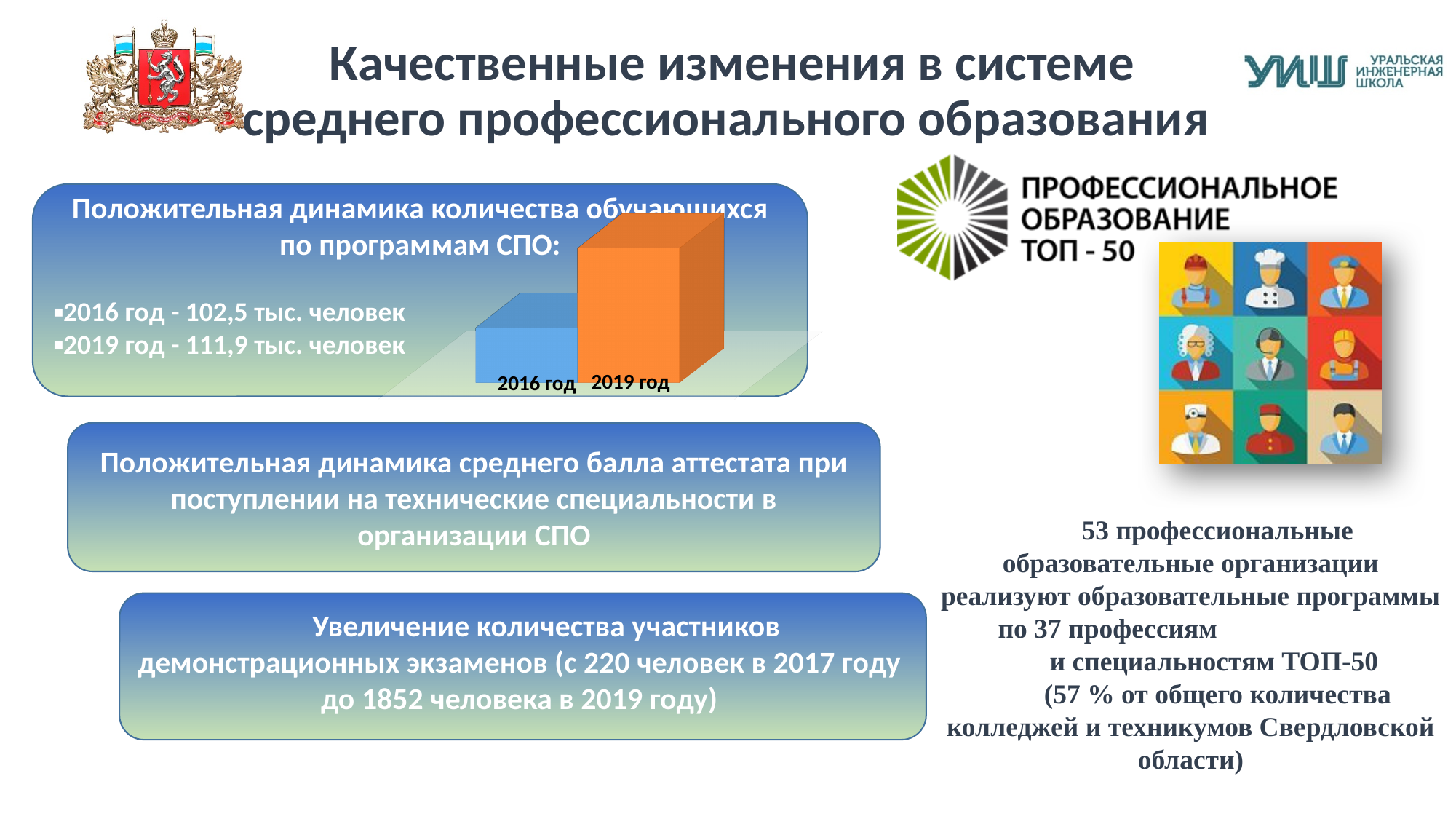
What kind of chart is shown on the slide? bar chart How many bars does the chart have? 2 Which year has the taller bar in the chart? 2019 год According to the slide, how many students were enrolled in SPO programmes in 2016? 102,5 тыс. человек Is the bar for 2019 год taller or shorter than the bar for 2016 год? taller What colour is the bar for 2016 год? blue Do the values rise or fall from 2016 год to 2019 год? rise What colour is the bar for 2019 год? orange According to the slide, how many students were enrolled in SPO programmes in 2019? 111,9 тыс. человек What are the two category labels on the chart's x axis? 2016 год and 2019 год Which year has the shorter bar in the chart? 2016 год By how much did the number of SPO students grow from 2016 to 2019, according to the figures on the slide? 9,4 тыс. человек